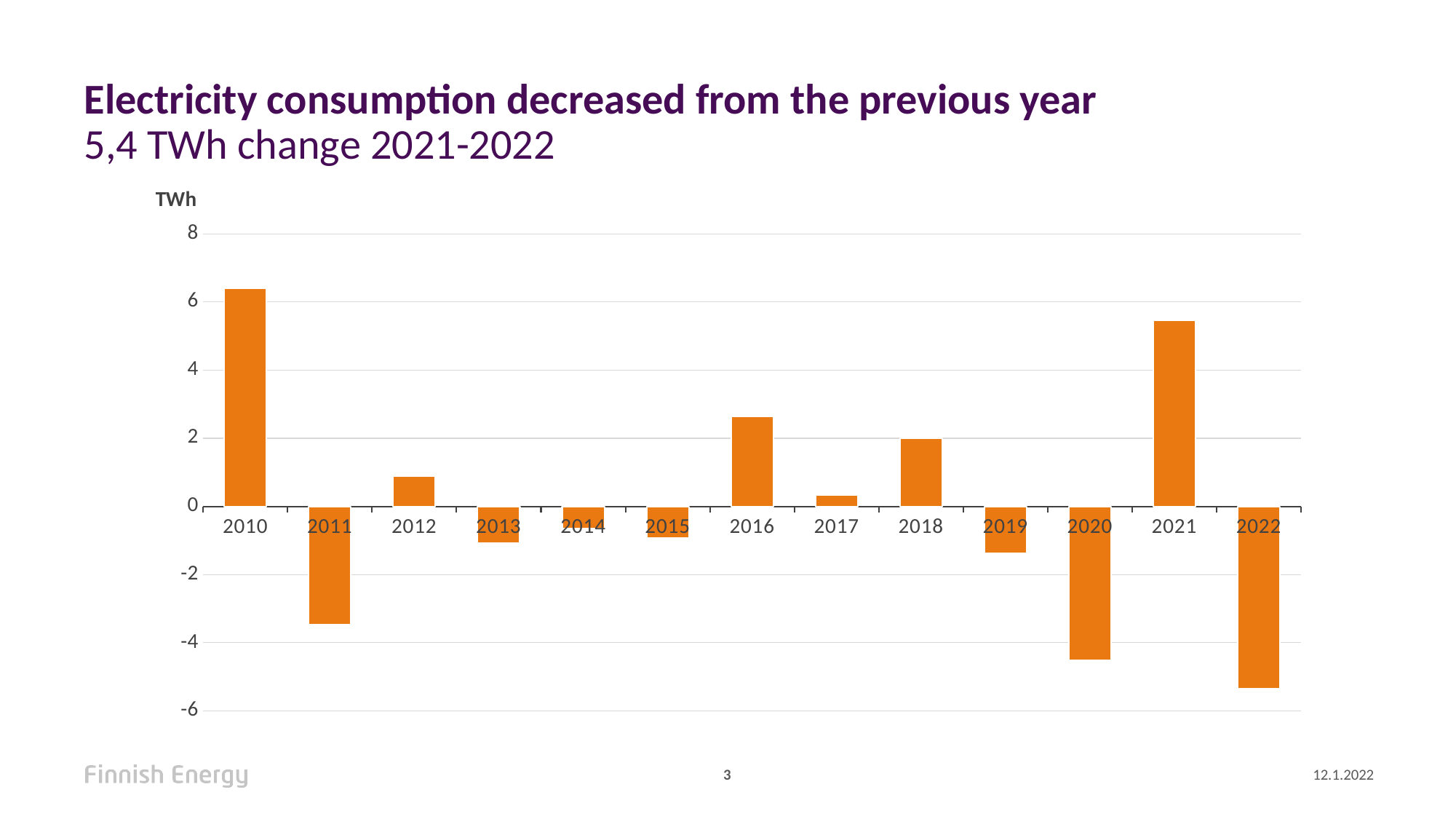
What unit is shown on the y axis of the chart? TWh Is the value for 2020 greater or less than -4? less Which year has the lowest value in the chart? 2022 Which year has the larger value, 2016 or 2018? 2016 Is the value for 2011 greater or less than -2? less Is the value for 2021 greater or less than 4? greater How many years are plotted on the x axis of the chart? 13 How many years in the chart have a negative value? 7 Which year has the highest value in the chart? 2010 Which year has the lower value, 2011 or 2020? 2020 What kind of chart is shown on the slide? Bar chart